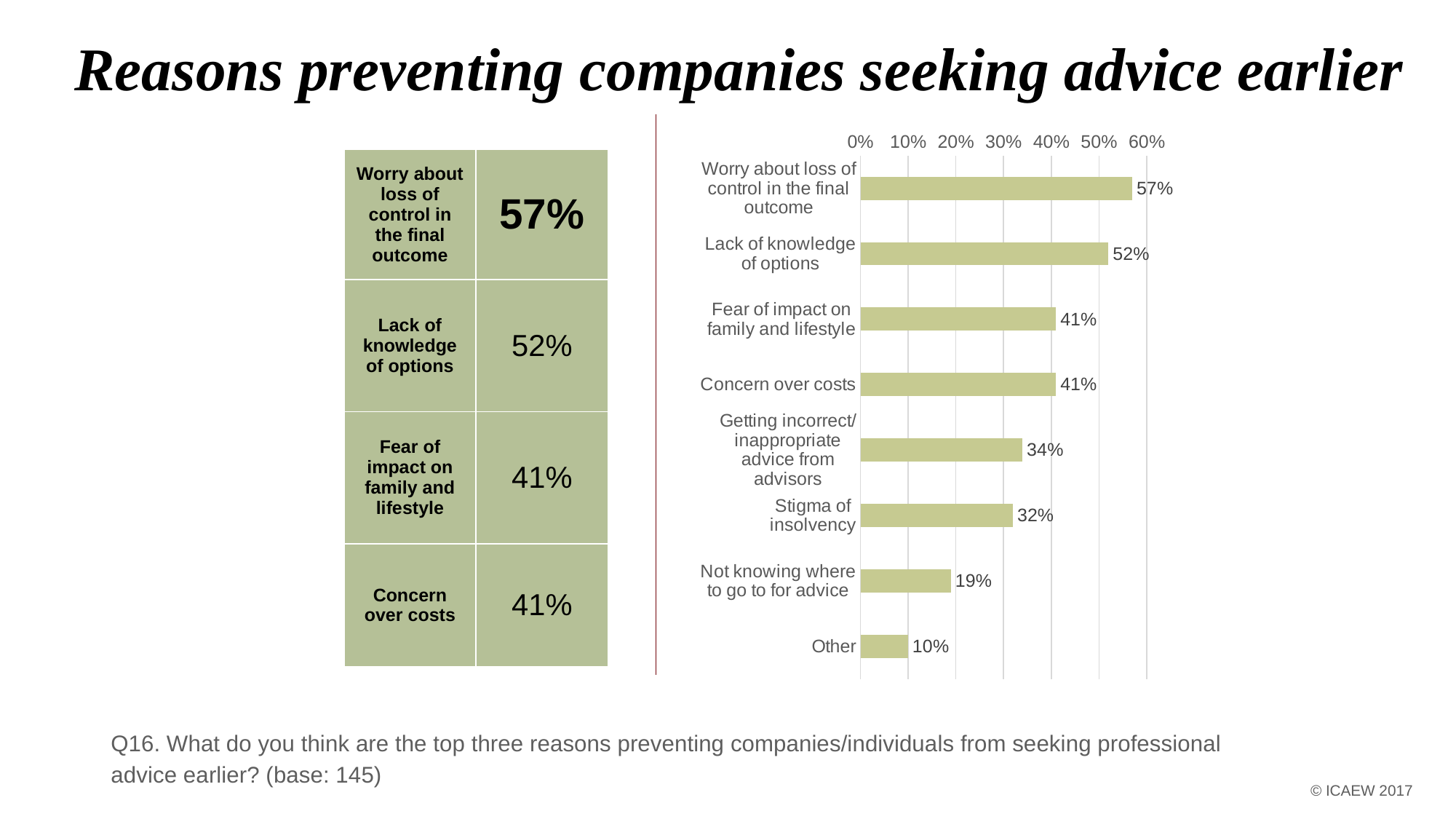
What percentage is shown for 'Getting incorrect/inappropriate advice from advisors'? 34% Which is larger: the value for 'Fear of impact on family and lifestyle' or the value for 'Getting incorrect/inappropriate advice from advisors'? Fear of impact on family and lifestyle Which reason has the highest percentage in the chart? Worry about loss of control in the final outcome How many reasons (categories) are plotted in the bar chart? 8 What is the difference in percentage points between 'Lack of knowledge of options' and 'Stigma of insolvency'? 20 percentage points What percentage is shown for 'Worry about loss of control in the final outcome'? 57% What percentage is shown for 'Not knowing where to go to for advice'? 19% Is the value for 'Lack of knowledge of options' greater or less than 50%? greater What type of chart is used on the slide? Bar chart Which reason has the lowest percentage in the chart? Other What percentage is shown for 'Stigma of insolvency'? 32% What is the highest value shown on the percentage axis of the chart? 60%